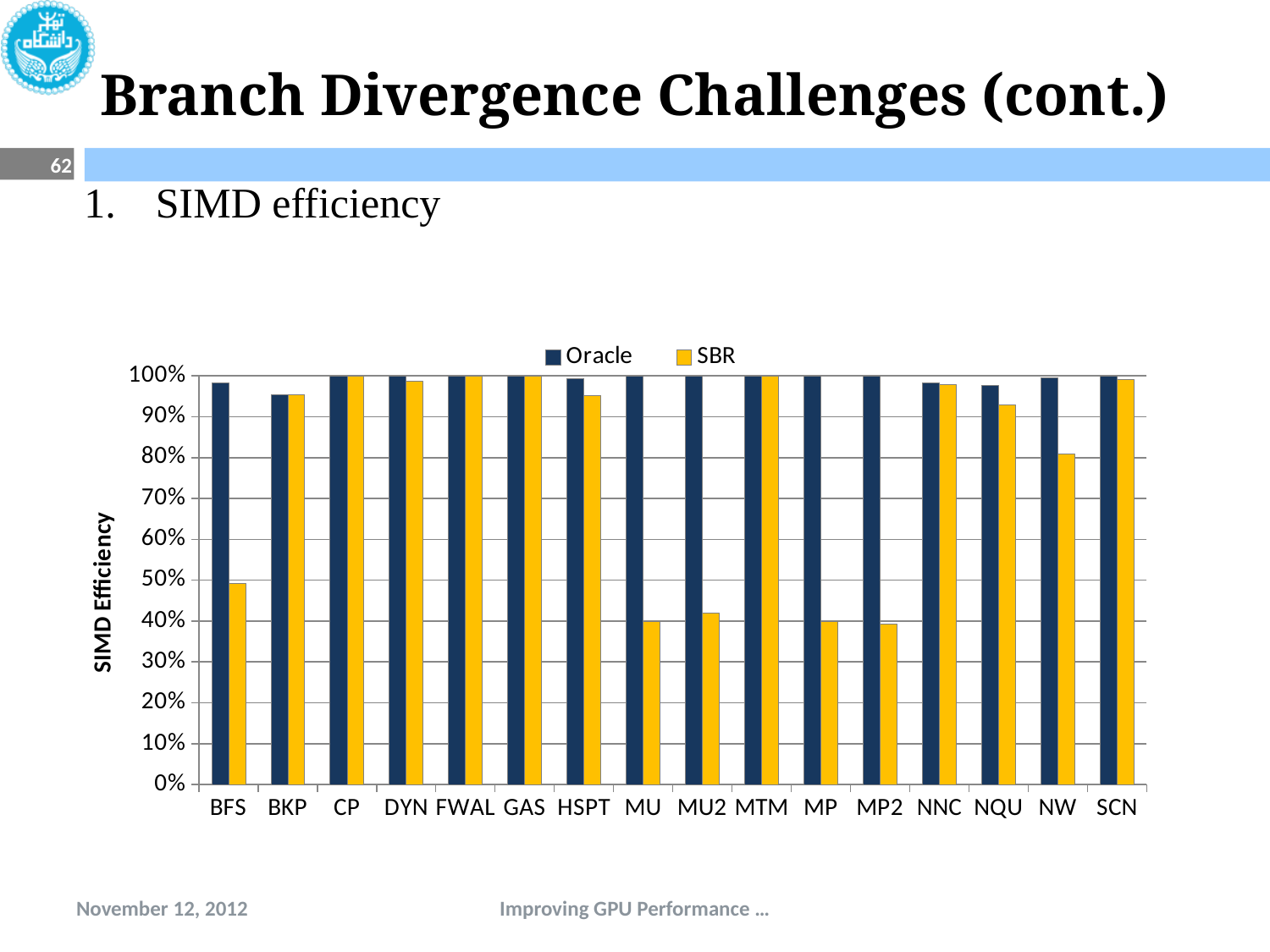
For BFS, which series has the larger value, Oracle or SBR? Oracle Is the SBR value for MP2 greater or less than 50%? less Which series in the chart is drawn in yellow? SBR Is the SBR value for NW greater or less than 90%? less Is the SBR value for NW greater or less than 70%? greater How many series does the chart legend list? 2 For NW, which series has the larger value, Oracle or SBR? Oracle What kind of chart is shown on the slide? bar chart What is the label of the vertical axis of the chart? SIMD Efficiency How many benchmark categories are shown along the x axis of the chart? 16